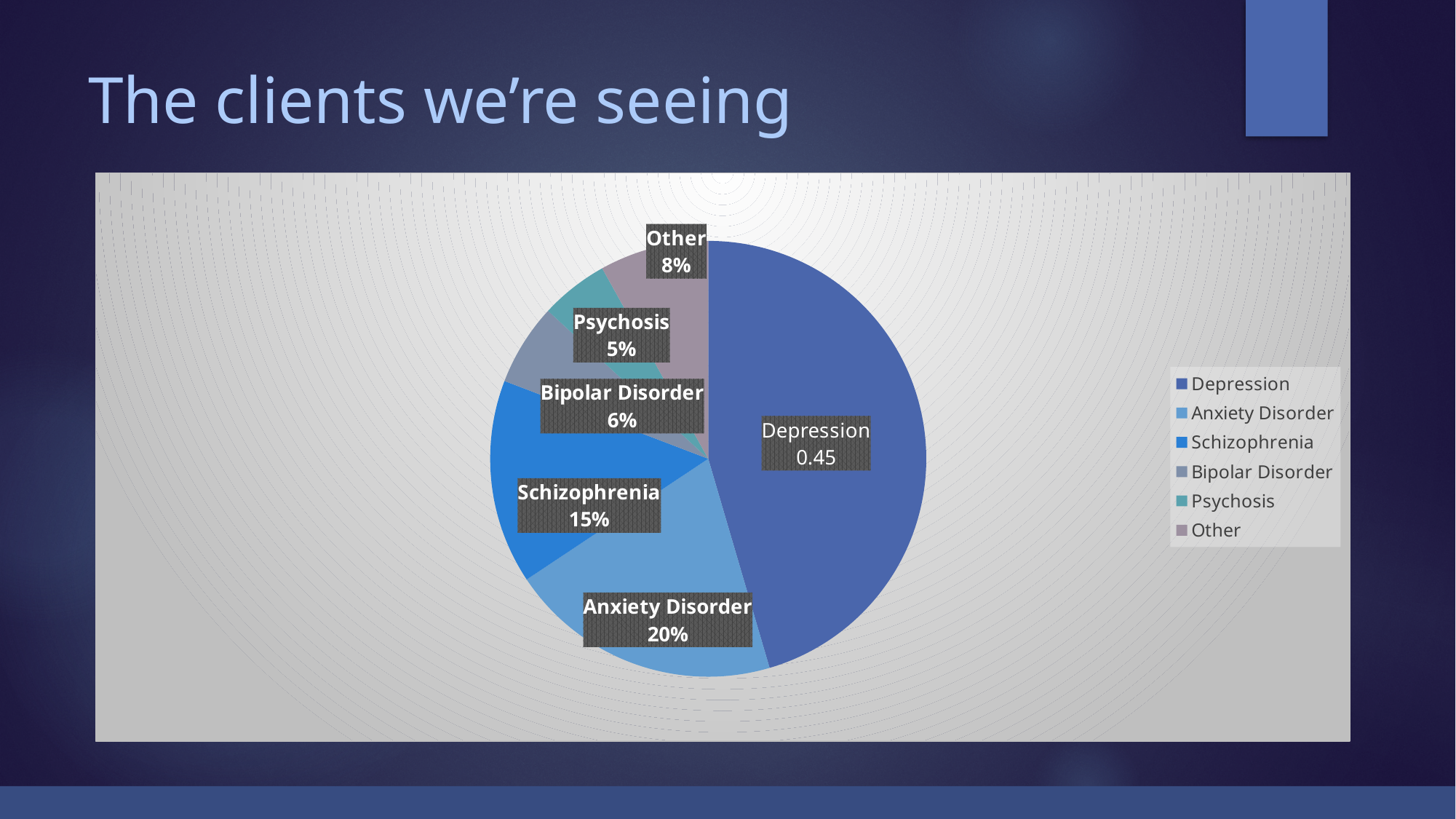
What percentage is shown for Bipolar Disorder? 6% What percentage is shown for Psychosis? 5% What percentage is shown for Anxiety Disorder? 20% Which category has the smallest slice of the pie? Psychosis What kind of chart is shown on the slide? Pie chart What percentage is shown for the Other slice? 8% What value is shown for the Depression slice? 0.45 How many categories does the pie chart show? 6 What percentage is shown for Schizophrenia? 15% What is the difference between the Anxiety Disorder and Schizophrenia percentages? 5% Which category has the largest slice of the pie? Depression Which is larger, the Other slice or the Psychosis slice? Other